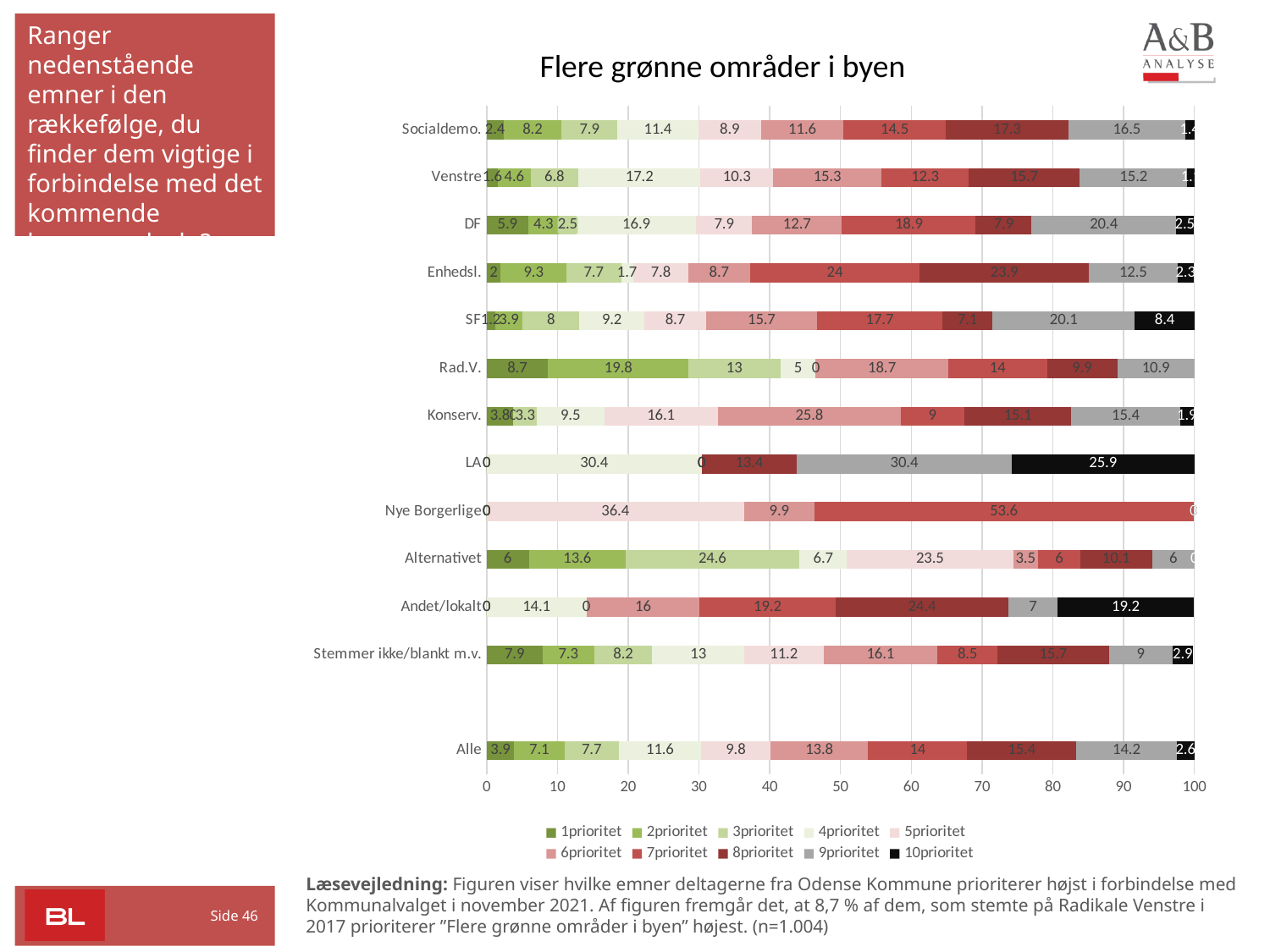
How many categories are shown on the y axis of the chart? 13 What is the value of the 7prioritet segment for Nye Borgerlige? 53.6 What is the value of the 1prioritet segment for Alle? 3.9 What is the value of the 6prioritet segment for Konserv.? 25.8 What is the value of the 10prioritet segment for LA? 25.9 What is the value of the 2prioritet segment for Rad.V.? 19.8 Which category has the highest 1prioritet value? Rad.V. Which is larger, the 6prioritet value for Konserv. or the 6prioritet value for Alle? Konserv. How many series does the legend list? 10 What type of chart is shown on the slide? Stacked bar chart What is the value of the 9prioritet segment for Socialdemo.? 16.5